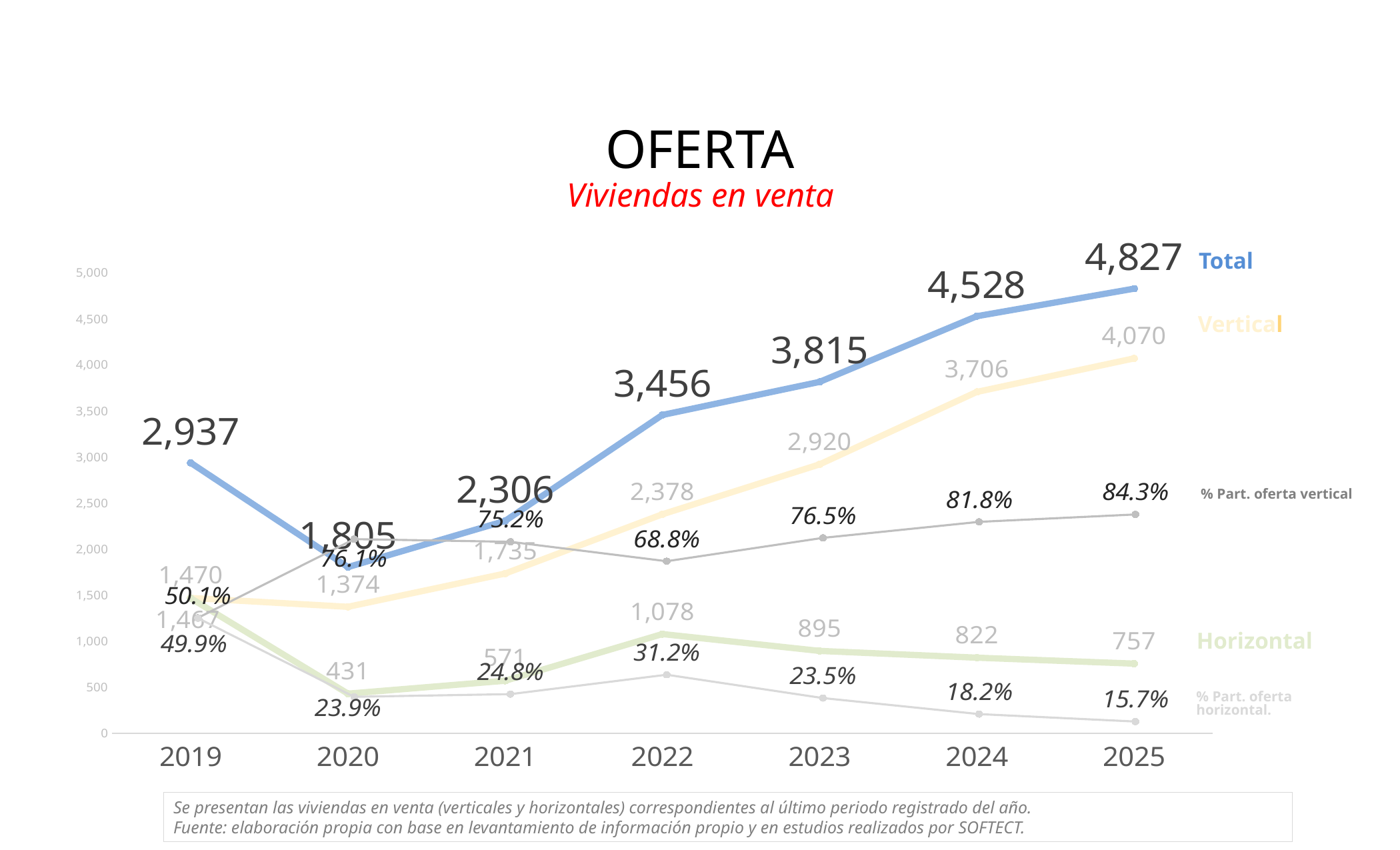
What is the % Part. oferta horizontal value for 2020? 23.9% What kind of chart is shown on the slide? Line chart What is the Vertical value for 2024? 3,706 In which year is the Total value lowest? 2020 Which is larger, the Horizontal value for 2021 or for 2023? 2023 What is the Total value for 2025? 4,827 What is the difference between the Total values for 2025 and 2024? 299 What is the Horizontal value for 2022? 1,078 What is the % Part. oferta vertical value for 2023? 76.5% In which year is the Vertical value highest? 2025 Does the Total value rise or fall from 2020 to 2025? Rise How many years are shown on the x axis? 7